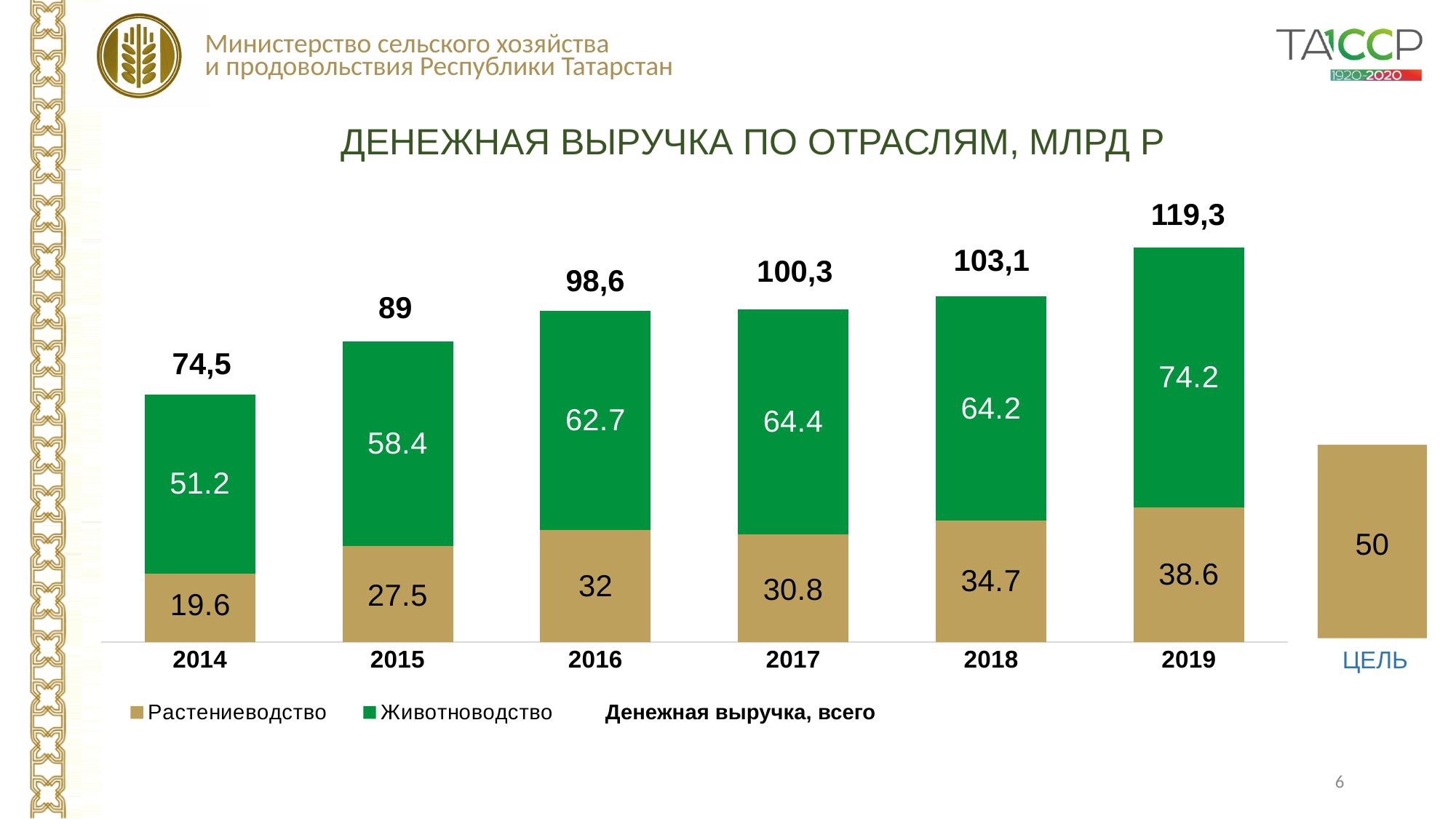
How many years (excluding ЦЕЛЬ) are shown on the x axis? 6 Which is larger: Растениеводство in 2017 or Растениеводство in 2018? Растениеводство in 2018 Which year has the highest total Денежная выручка? 2019 What is the value for Животноводство in 2017? 64.4 What is the total Денежная выручка shown above the 2019 bar? 119,3 Which year has the lowest value for Растениеводство? 2014 What value is shown on the ЦЕЛЬ bar? 50 What kind of chart is shown on the slide? Stacked bar chart What is the value for Растениеводство in 2016? 32 What is the difference between the Животноводство values for 2019 and 2014? 23 Does the total Денежная выручка rise or fall from 2014 to 2019? Rises